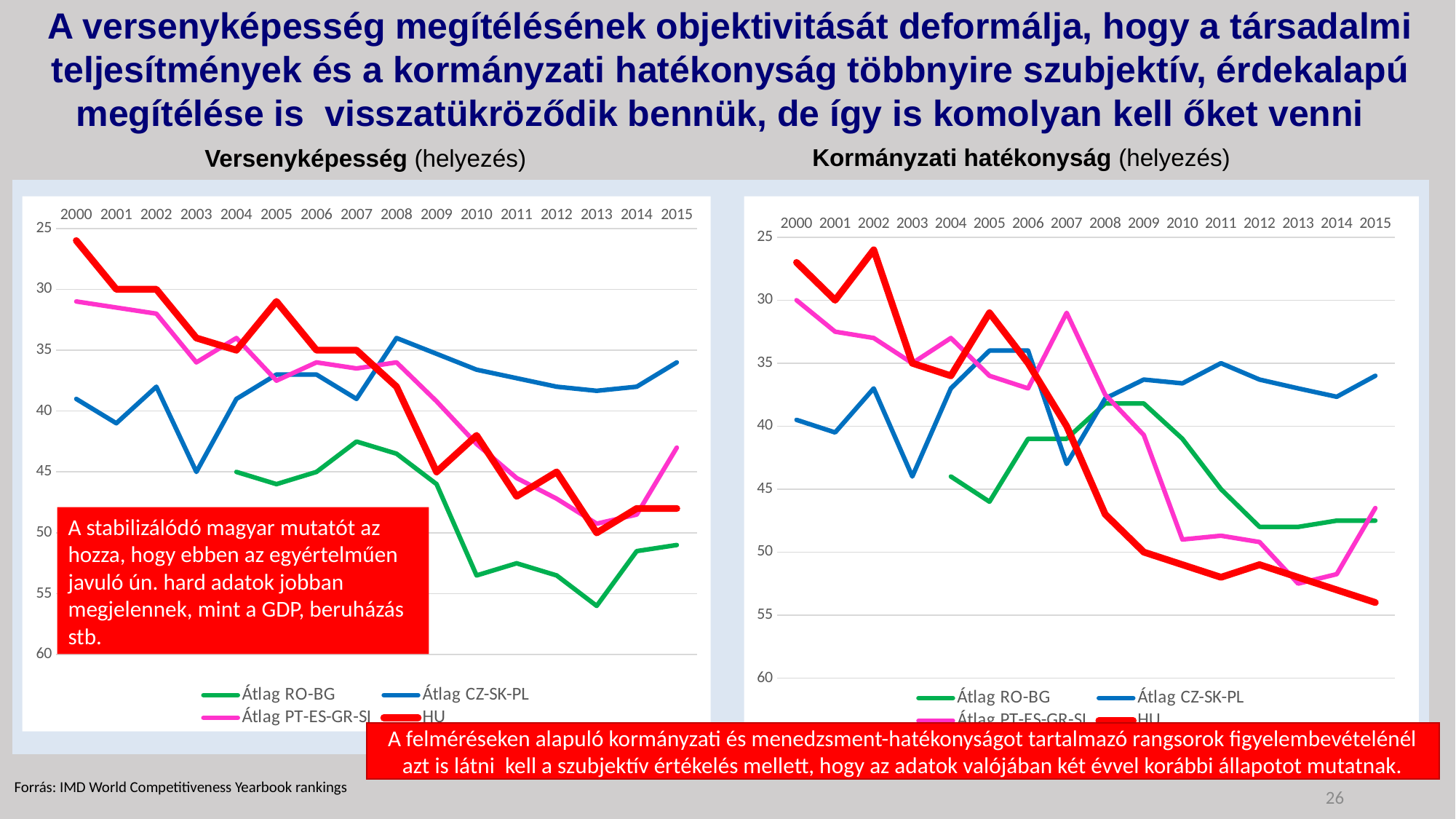
What colour is the HU series drawn in on both charts? red In the Versenyképesség (helyezés) chart, which is larger in 2015: the HU value or the Átlag CZ-SK-PL value? HU What kind of chart is the Versenyképesség (helyezés) chart? line chart How many years are shown on the x axis of the Versenyképesség (helyezés) chart? 16 In the Kormányzati hatékonyság (helyezés) chart, is the HU value for 2015 greater or less than 50? greater In the Versenyképesség (helyezés) chart, which is larger: the HU value in 2000 or the HU value in 2015? 2015 In the Versenyképesség (helyezés) chart, is the Átlag CZ-SK-PL value for 2015 greater or less than 40? less In the Kormányzati hatékonyság (helyezés) chart, is the HU value for 2000 greater or less than 30? less In the Kormányzati hatékonyság (helyezés) chart, which is larger in 2015: the HU value or the Átlag RO-BG value? HU How many series does the legend of the Kormányzati hatékonyság (helyezés) chart list? 4